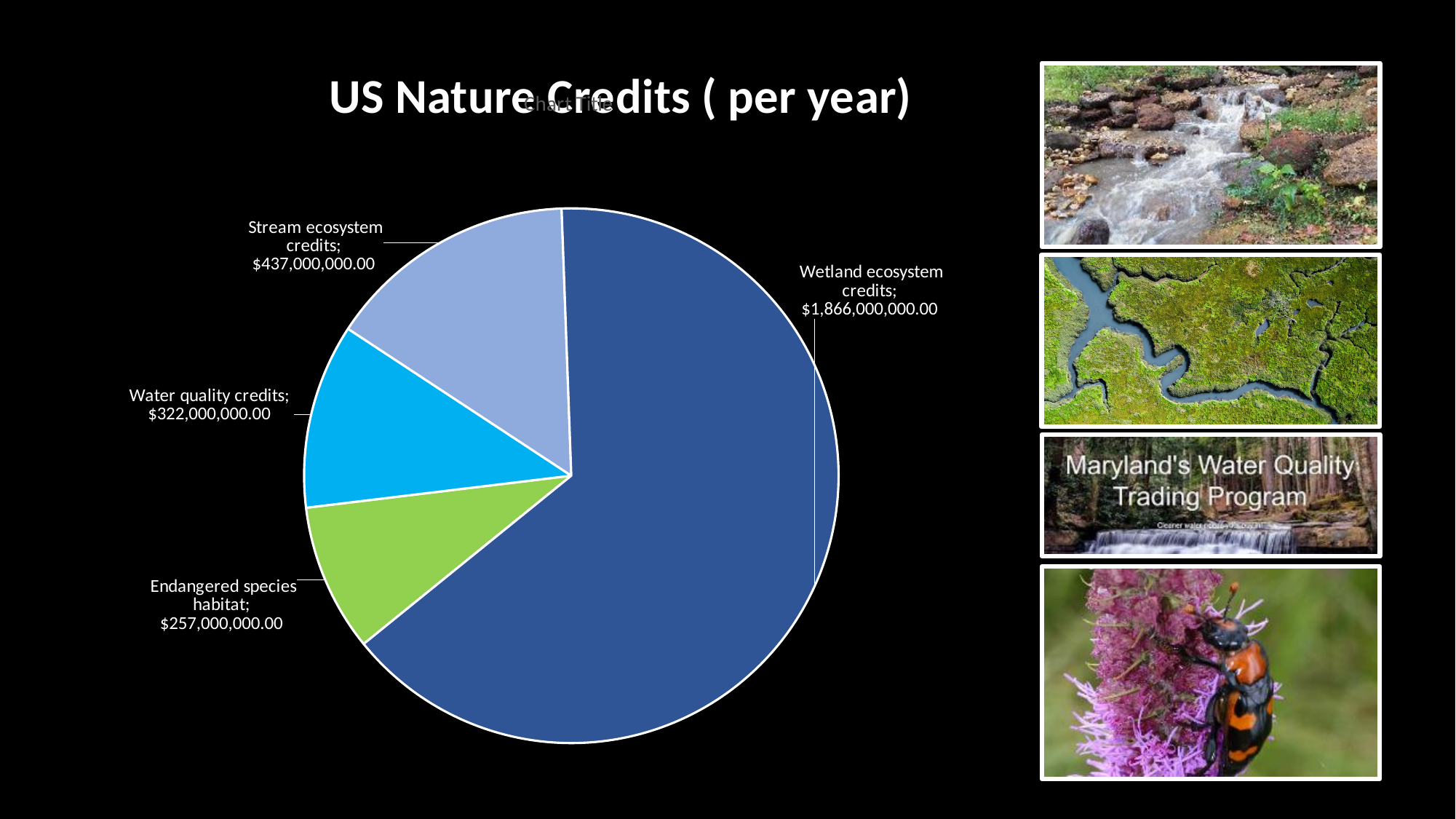
What kind of chart is shown on the slide? Pie chart What is the title of the chart? US Nature Credits ( per year) Which is larger, Stream ecosystem credits or Water quality credits? Stream ecosystem credits What is the value for Water quality credits? $322,000,000.00 What is the difference between Water quality credits and Endangered species habitat? $65,000,000.00 What is the value for Stream ecosystem credits? $437,000,000.00 How many slices does the pie chart have? 4 Which category has the largest slice of the pie? Wetland ecosystem credits What is the value for Wetland ecosystem credits? $1,866,000,000.00 What is the difference between Wetland ecosystem credits and Stream ecosystem credits? $1,429,000,000.00 What is the value for Endangered species habitat? $257,000,000.00 Which category has the smallest slice of the pie? Endangered species habitat